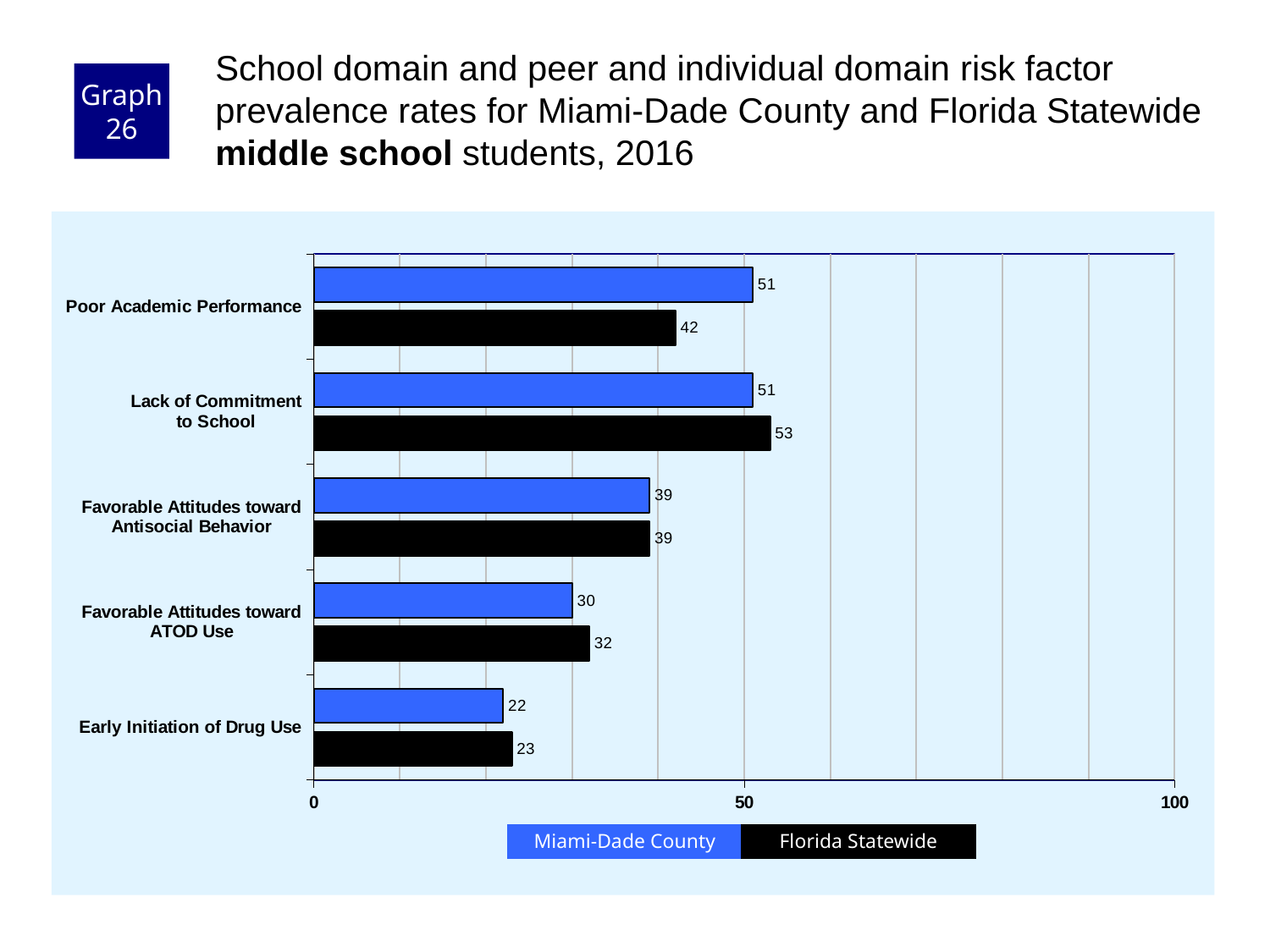
What kind of chart is shown on the slide? bar chart How many risk factors are shown on the chart? 5 For Favorable Attitudes toward ATOD Use, which is larger: the Miami-Dade County value or the Florida Statewide value? Florida Statewide Which risk factor has the lowest Florida Statewide value? Early Initiation of Drug Use How many series does the legend list? 2 What is the Miami-Dade County value for Early Initiation of Drug Use? 22 What is the Florida Statewide value for Lack of Commitment to School? 53 What is the difference between the Miami-Dade County and Florida Statewide values for Poor Academic Performance? 9 Which risk factor has the highest Florida Statewide value? Lack of Commitment to School What is the Miami-Dade County value for Poor Academic Performance? 51 Which colour represents Florida Statewide in the chart? black Is the Florida Statewide value for Poor Academic Performance greater or less than 50? less